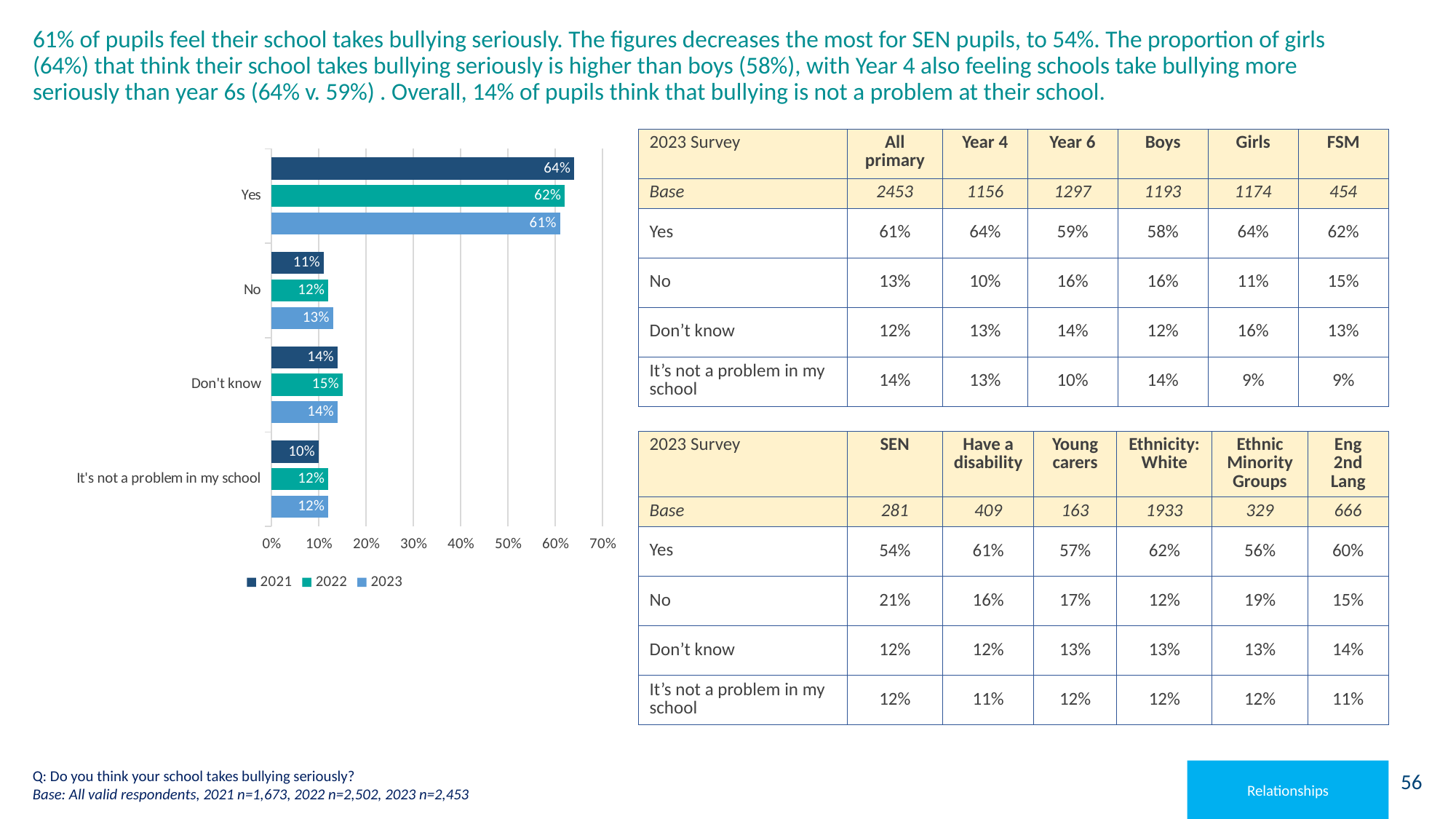
What is the 2022 value for 'Don't know' in the chart? 15% Which response category has the highest value for 2023 in the chart? Yes Which is larger in the chart: the 2021 value for 'No' or the 2023 value for 'No'? 2023 What is the 2023 value for 'Yes' in the chart? 61% What is the 2021 value for 'It's not a problem in my school' in the chart? 10% Which response category has the lowest value for 2021 in the chart? It's not a problem in my school What kind of chart is shown on the slide? bar chart What is the difference between the 2021 and 2023 values for 'Yes' in the chart? 3% How many response categories are shown on the chart? 4 What is the 2021 value for 'Yes' in the chart? 64% Does the 'Yes' value rise or fall from 2021 to 2023 in the chart? fall How many series does the chart legend list? 3